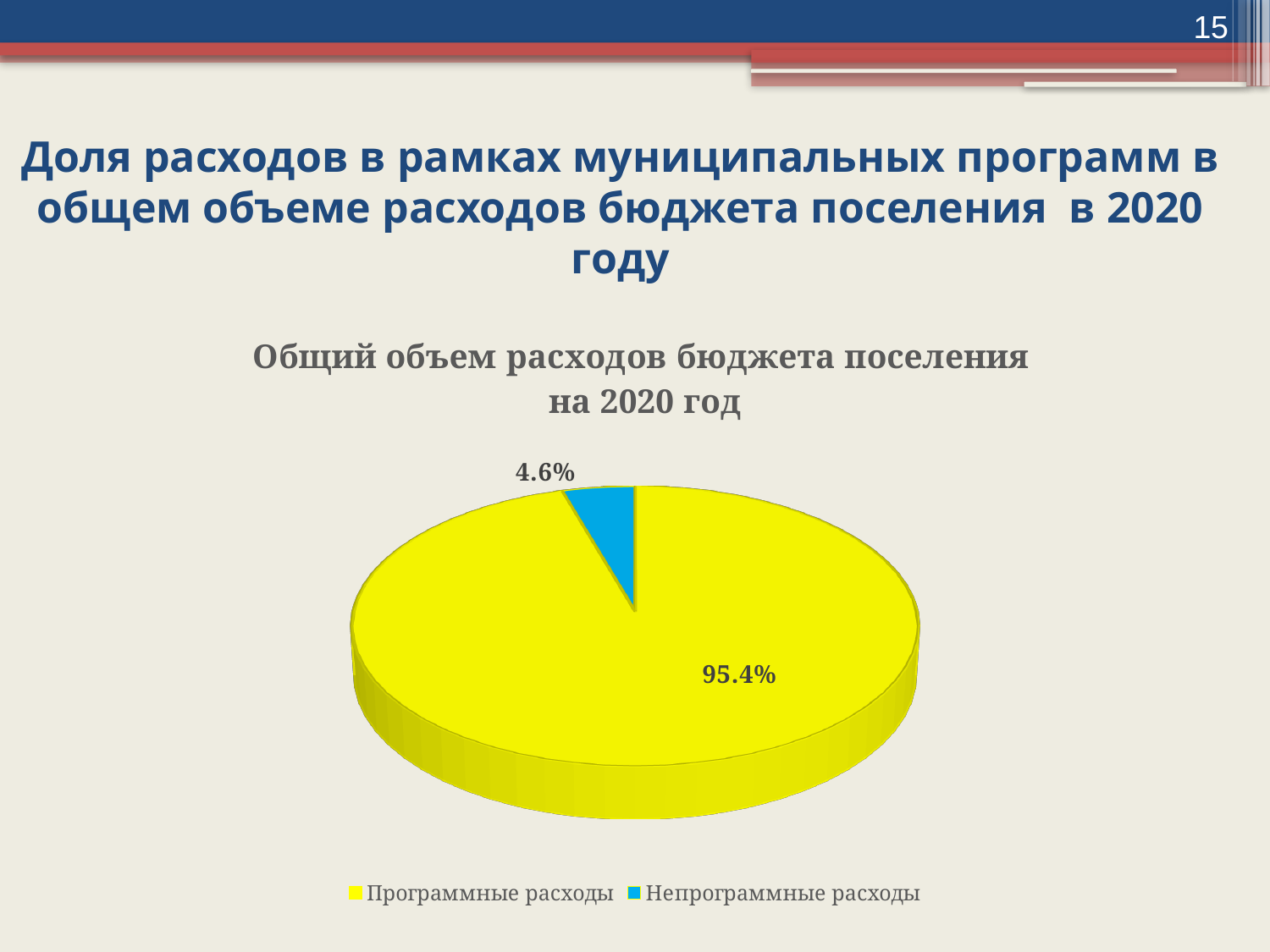
What is the share of Непрограммные расходы in the pie chart? 4.6% How many entries does the legend list? 2 What is the difference in percentage points between Программные расходы and Непрограммные расходы? 90.8 What is the title of the chart? Общий объем расходов бюджета поселения на 2020 год What colour is the slice for Непрограммные расходы? blue Which category has the largest slice of the pie? Программные расходы Which category has the smallest slice of the pie? Непрограммные расходы What is the share of Программные расходы in the pie chart? 95.4% Which is larger: the share of Программные расходы or the share of Непрограммные расходы? Программные расходы How many slices does the pie chart have? 2 What kind of chart is shown on the slide? pie chart